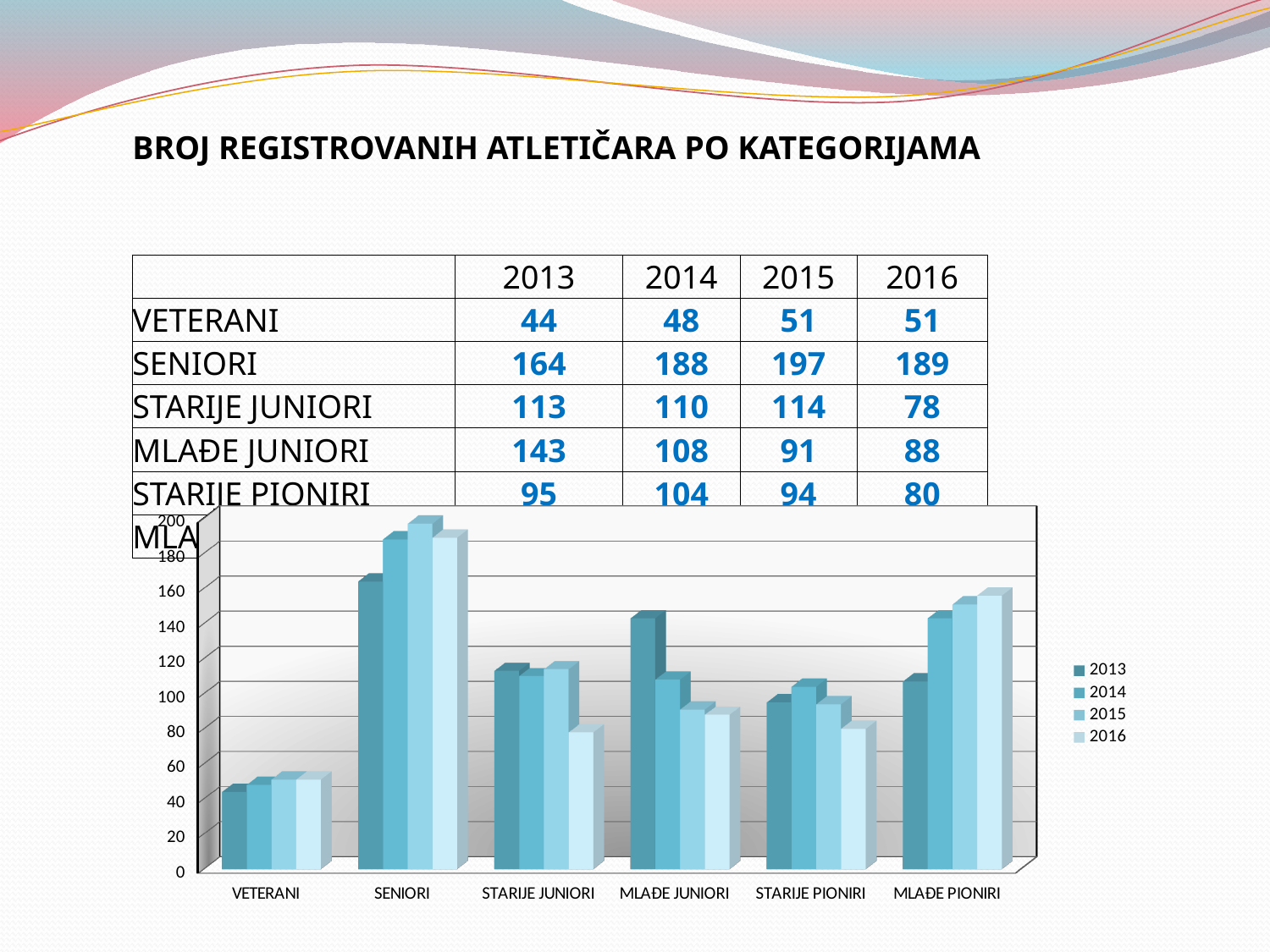
What is the value for SENIORI in 2015? 197 Do the values for MLAĐE JUNIORI rise or fall from 2013 to 2016? fall What is the value for VETERANI in 2016? 51 Is the value for MLAĐE PIONIRI in 2013 greater or less than 120? less How many categories are shown along the x axis of the chart? 6 What is the difference between the SENIORI values for 2014 and 2013? 24 How many series does the chart's legend list? 4 What kind of chart is shown on the slide? bar chart Is the value for MLAĐE PIONIRI in 2016 greater or less than 140? greater Which category has the highest value in 2013? SENIORI Which category has the lowest value in 2014? VETERANI Which is larger in 2013: STARIJE JUNIORI or MLAĐE JUNIORI? MLAĐE JUNIORI